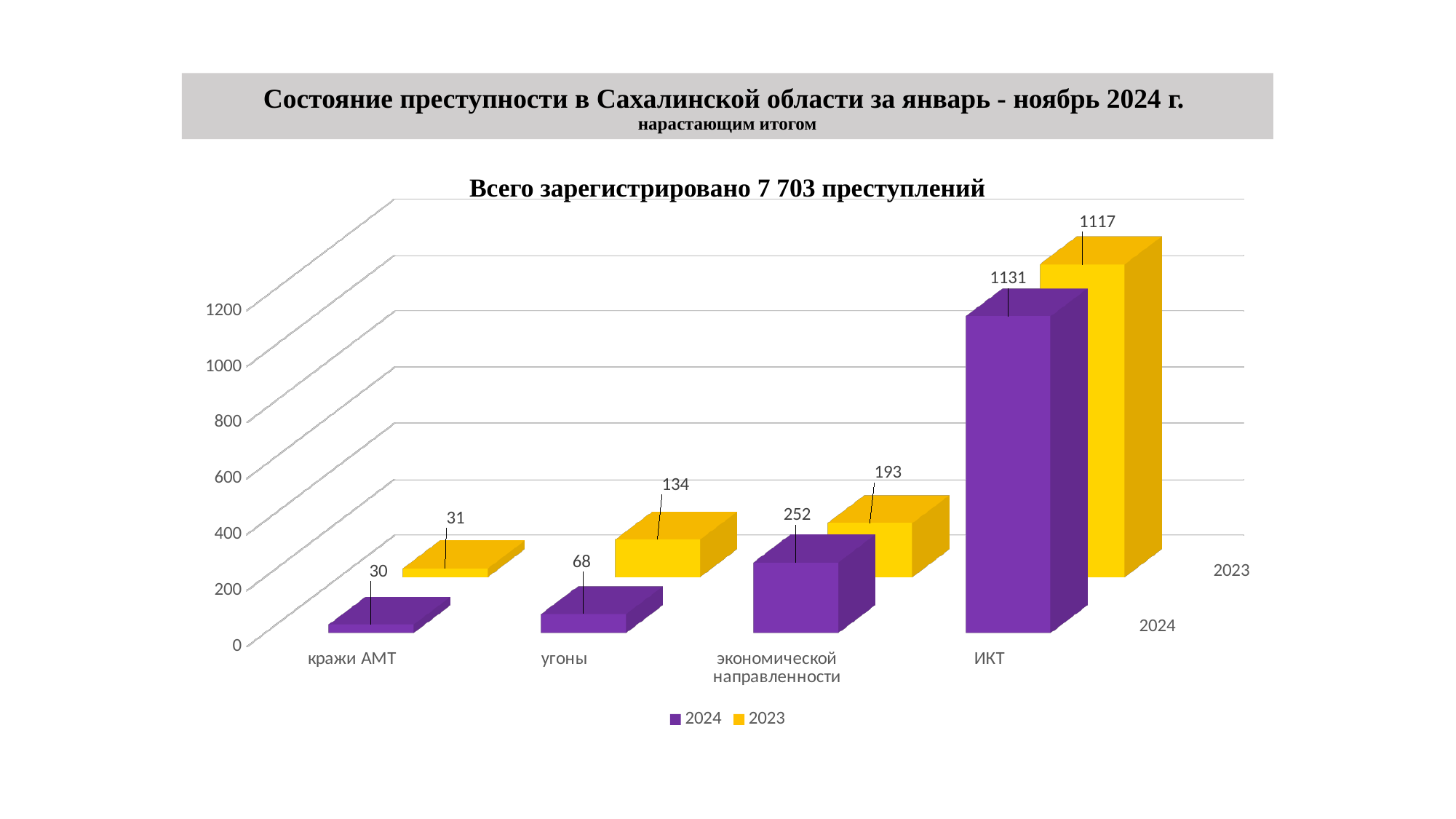
What is the value for ИКТ in the 2024 series? 1131 What is the value for экономической направленности in the 2024 series? 252 What is the value for угоны in the 2023 series? 134 What is the chart title? Всего зарегистрировано 7 703 преступлений Which category has the highest value in the 2023 series? ИКТ What is the difference between the 2023 and 2024 values for угоны? 66 Which is larger for экономической направленности: the 2024 value or the 2023 value? 2024 What is the value for кражи АМТ in the 2023 series? 31 How many categories are shown on the x axis? 4 What kind of chart is shown on the slide? bar chart Which category has the lowest value in the 2024 series? кражи АМТ How many series does the legend list? 2